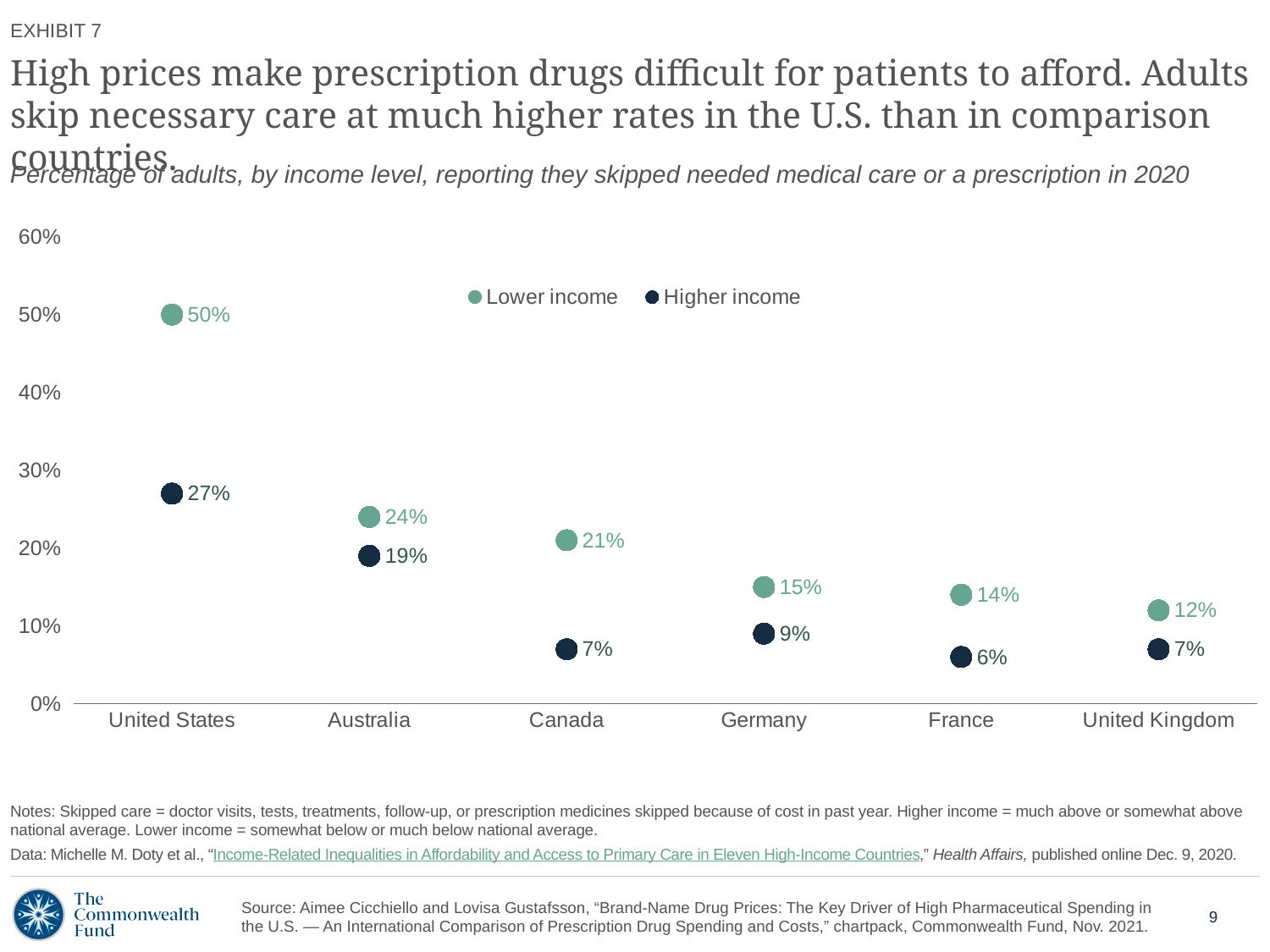
What is the difference between the lower-income and higher-income values for the United States? 23% How many series does the legend list? 2 What is the difference between the lower-income values for Canada and the United Kingdom? 9% What is the value for lower-income adults in Germany? 15% How many countries are shown on the x axis? 6 What percentage of lower-income adults in the United States reported skipping needed medical care or a prescription in 2020? 50% Which is larger: the higher-income value for Germany or the higher-income value for Canada? Germany Which country has the highest value for lower-income adults? United States What are the two series named in the legend? Lower income and Higher income What is the value for higher-income adults in Australia? 19% Which country has the lowest value for higher-income adults? France Do the lower-income values rise or fall moving from the United States to the United Kingdom along the x axis? fall